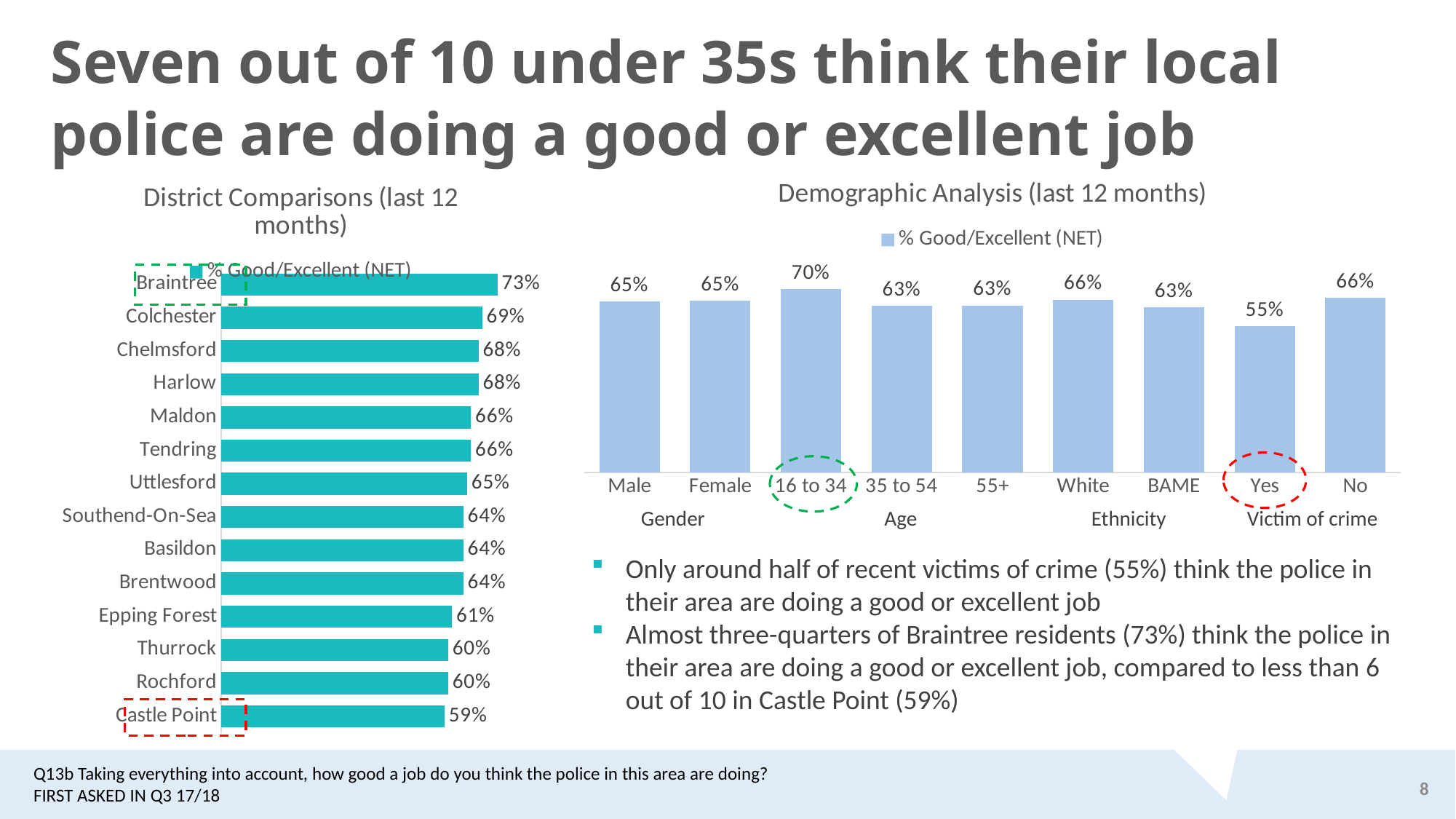
In the Demographic Analysis chart, what is the % Good/Excellent (NET) value for the 16 to 34 age group? 70% In the Demographic Analysis chart, what is the difference between the values for victims of crime (Yes) and non-victims (No)? 11 percentage points In the District Comparisons chart, how many districts are shown? 14 In the District Comparisons chart, what is the value for Epping Forest? 61% In the Demographic Analysis chart, how many categories are plotted? 9 In the District Comparisons chart, which district has the highest % Good/Excellent (NET) value? Braintree In the Demographic Analysis chart, which is larger: the value for White or the value for BAME? White In the District Comparisons chart, what is the % Good/Excellent (NET) value for Colchester? 69% What type of chart is the Demographic Analysis chart? Bar chart In the Demographic Analysis chart, which category has the lowest value? Yes (Victim of crime) In the District Comparisons chart, what is the difference between the values for Braintree and Castle Point? 14 percentage points In the District Comparisons chart, which district has the lowest % Good/Excellent (NET) value? Castle Point